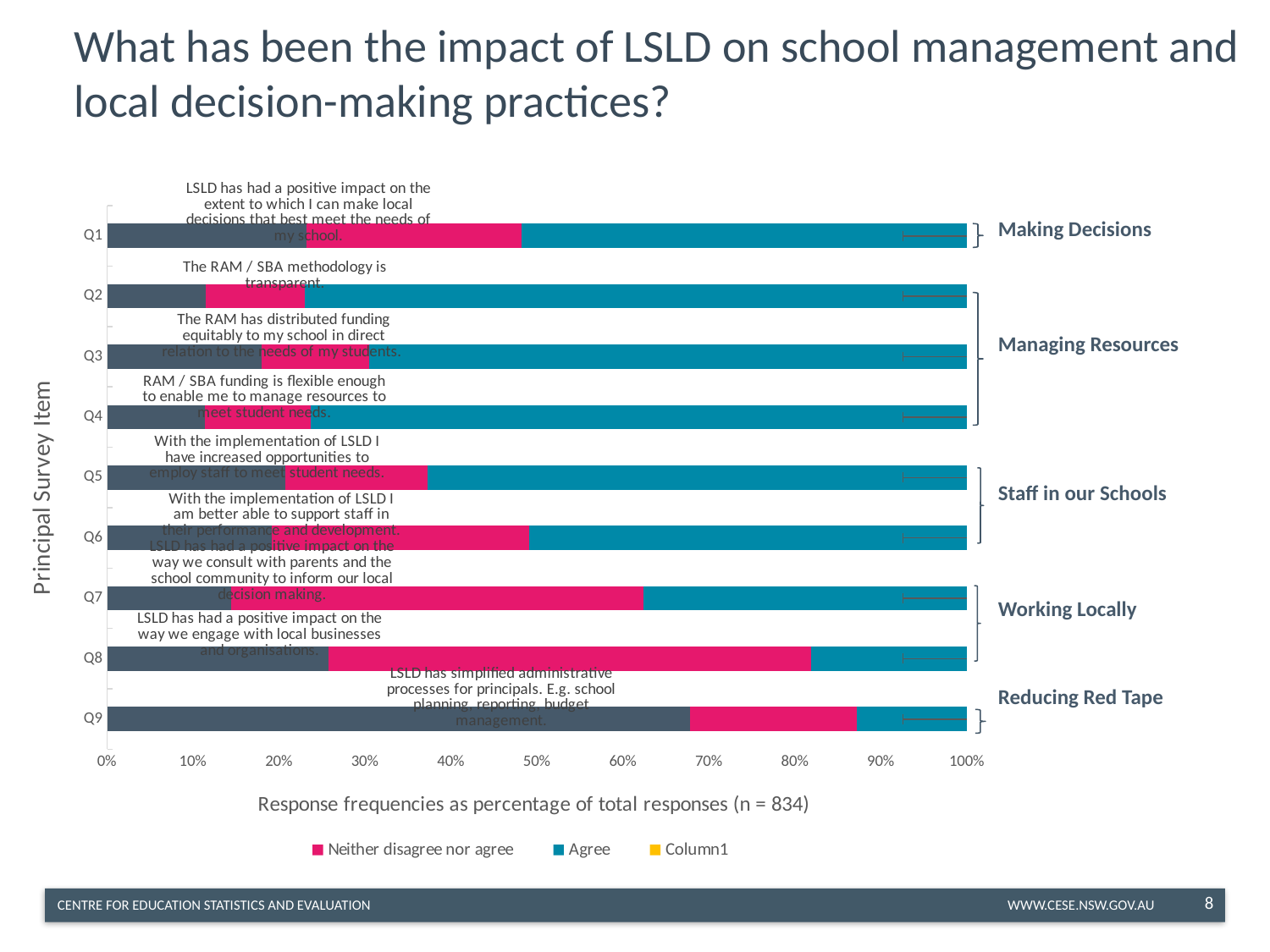
Which survey item has the largest 'Neither disagree nor agree' (pink) segment? Q8 Which survey item has the largest dark grey segment? Q9 Is the dark grey segment for Q1 greater or less than 30%? less Which has the larger dark grey segment, Q9 or Q2? Q9 Does the dark grey segment for Q9 end above or below 70%? below Which group label is shown next to Q9 on the right of the chart? Reducing Red Tape What kind of chart is shown on the slide? Stacked bar chart What is the x-axis label of the chart? Response frequencies as percentage of total responses (n = 834) How many survey items (Q1 to Q9) are plotted on the chart? 9 How many series does the chart legend list? 3 Is the dark grey segment for Q9 greater or less than 60%? greater